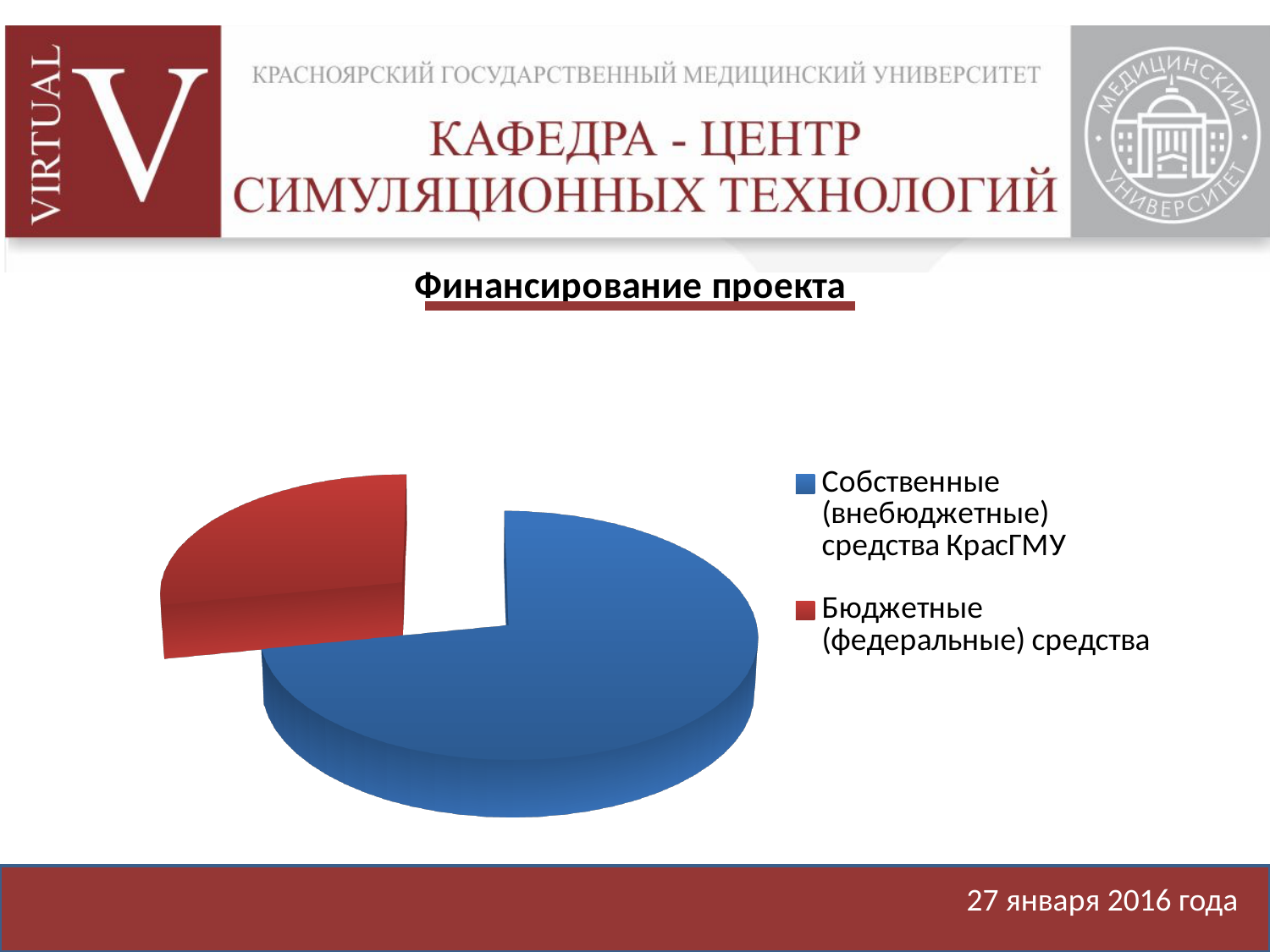
What colour is the slice for Бюджетные (федеральные) средства? red What is the title of the chart on the slide? Финансирование проекта How many entries does the legend of the pie chart list? 2 Which category has the largest slice of the pie chart? Собственные (внебюджетные) средства КрасГМУ Which slice is larger: Собственные (внебюджетные) средства КрасГМУ or Бюджетные (федеральные) средства? Собственные (внебюджетные) средства КрасГМУ How many slices does the pie chart have? 2 What kind of chart is shown on the slide? pie chart Which category has the smallest slice of the pie chart? Бюджетные (федеральные) средства